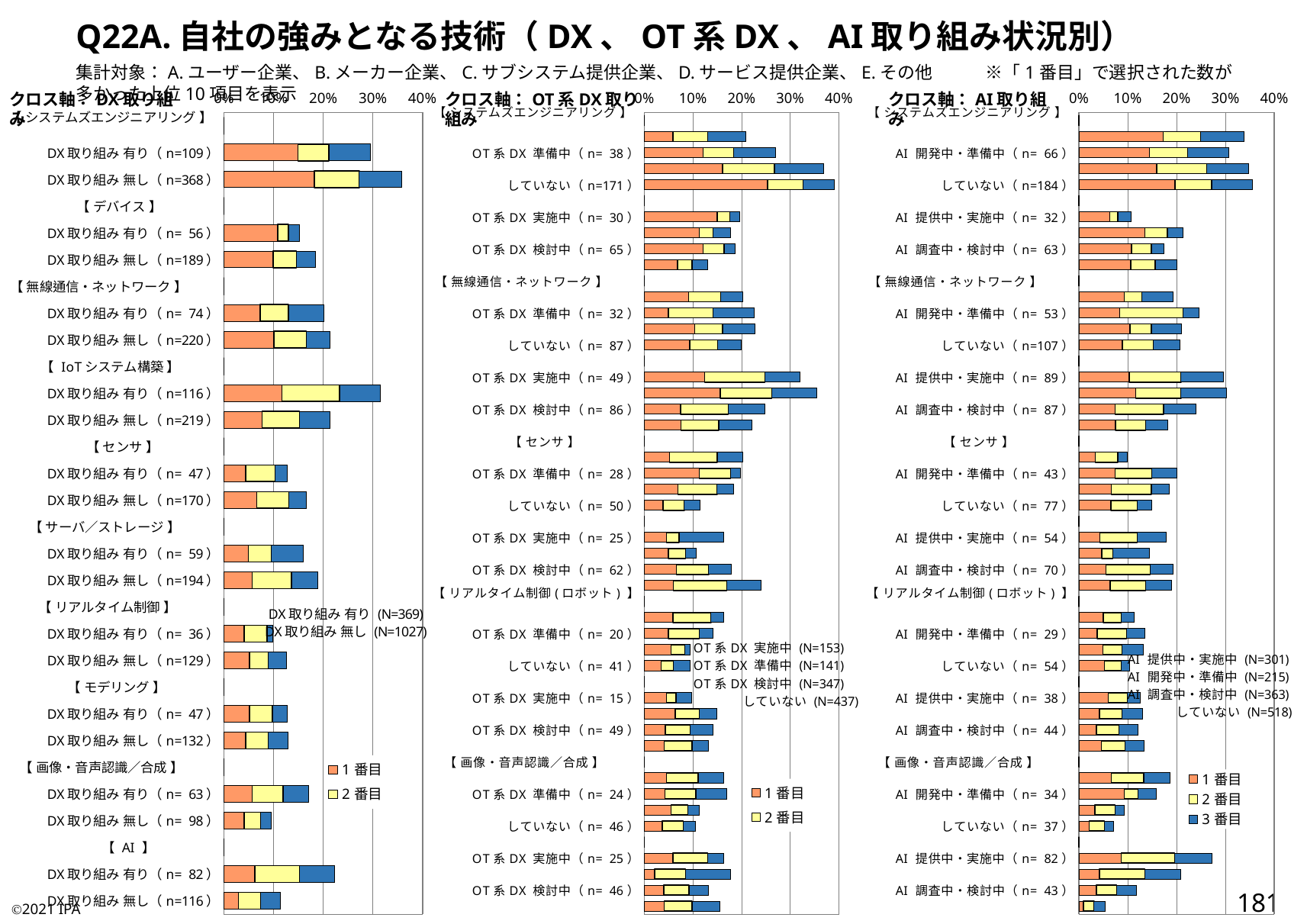
In the right chart (クロス軸：AI取り組み), what are the legend entries? 1番目, 2番目, 3番目 In the right chart (クロス軸：AI取り組み), under センサ, which bar is longer: AI開発中・準備中 (n=43) or していない (n=77)? AI開発中・準備中 (n=43) In the left chart (クロス軸：DX取り組み), under システムズエンジニアリング, which bar is longer: DX取り組み有り (n=109) or DX取り組み無し (n=368)? DX取り組み無し (n=368) In the left chart (クロス軸：DX取り組み), how many technology categories (bracketed headings) are shown? 10 In the left chart (クロス軸：DX取り組み), is the total value for システムズエンジニアリング DX取り組み無し (n=368) greater or less than 30%? greater In the right chart (クロス軸：AI取り組み), is the total value for システムズエンジニアリング していない (n=184) greater or less than 30%? greater What kind of chart is the left chart (クロス軸：DX取り組み)? bar chart In the left chart (クロス軸：DX取り組み), is the total value for デバイス DX取り組み有り (n=56) greater or less than 20%? less In the right chart (クロス軸：AI取り組み), how many series does the legend list? 3 In the left chart (クロス軸：DX取り組み), which bar is the longest overall? システムズエンジニアリング DX取り組み無し (n=368) In the left chart (クロス軸：DX取り組み), under IoTシステム構築, which bar is longer: DX取り組み有り (n=116) or DX取り組み無し (n=219)? DX取り組み有り (n=116)